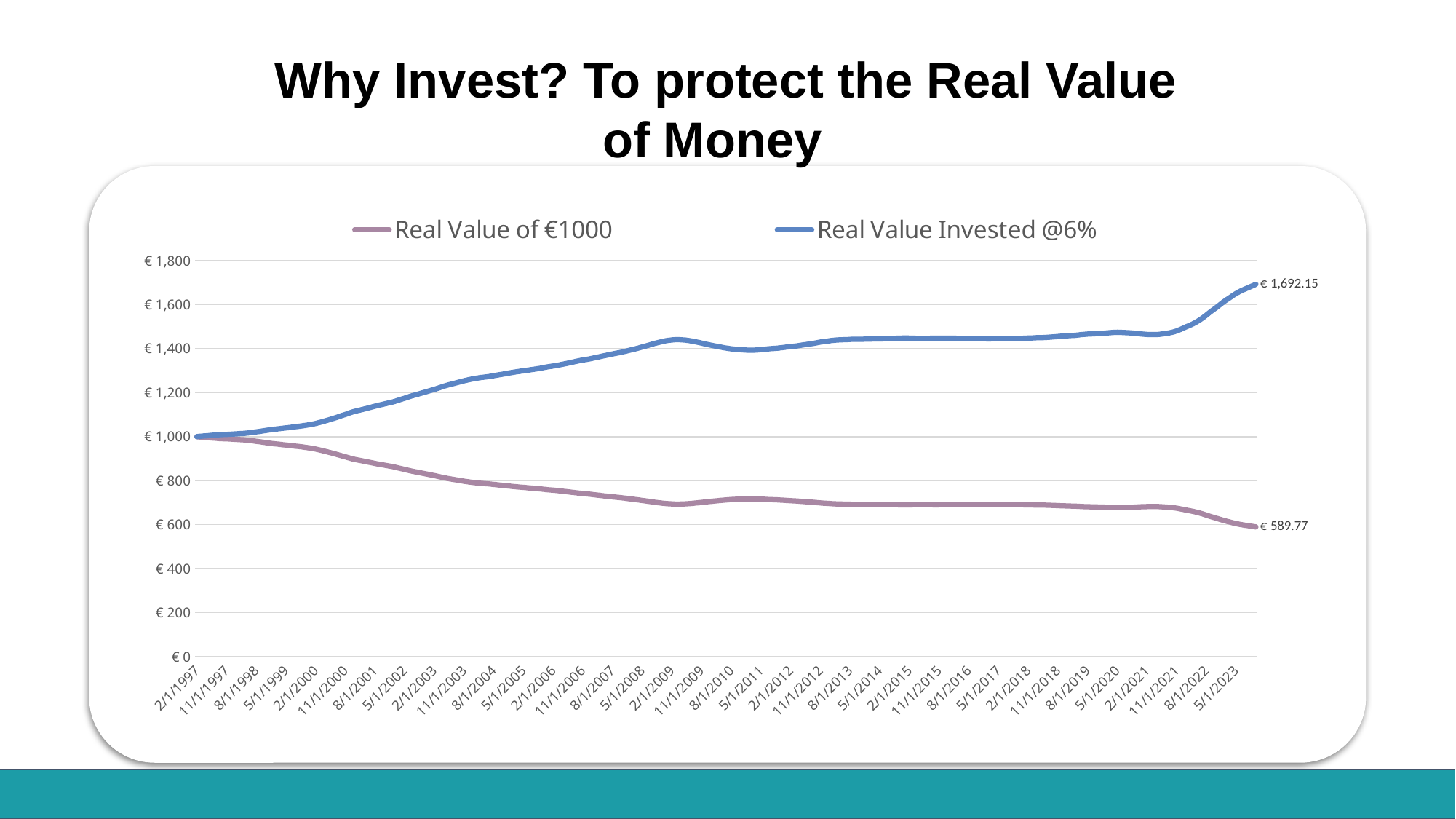
What type of chart is shown on the slide? Line chart Which series is drawn in blue on the chart? Real Value Invested @6% Does the Real Value Invested @6% series rise or fall over time along the x axis? Rise Which series has the higher value at the end of the chart (5/1/2023)? Real Value Invested @6% What is the difference between the final labelled values of the Real Value Invested @6% series and the Real Value of €1000 series? € 1,102.38 What is the final labelled value of the Real Value Invested @6% series? € 1,692.15 Is the value of the Real Value Invested @6% series at 5/1/2023 greater or less than € 1,600? greater Does the Real Value of €1000 series rise or fall over time along the x axis? Fall Is the value of the Real Value of €1000 series at 2/1/2009 greater or less than € 800? less What is the final labelled value of the Real Value of €1000 series? € 589.77 Is the value of the Real Value of €1000 series at 11/1/2000 greater or less than € 800? greater How many series does the chart legend list? 2